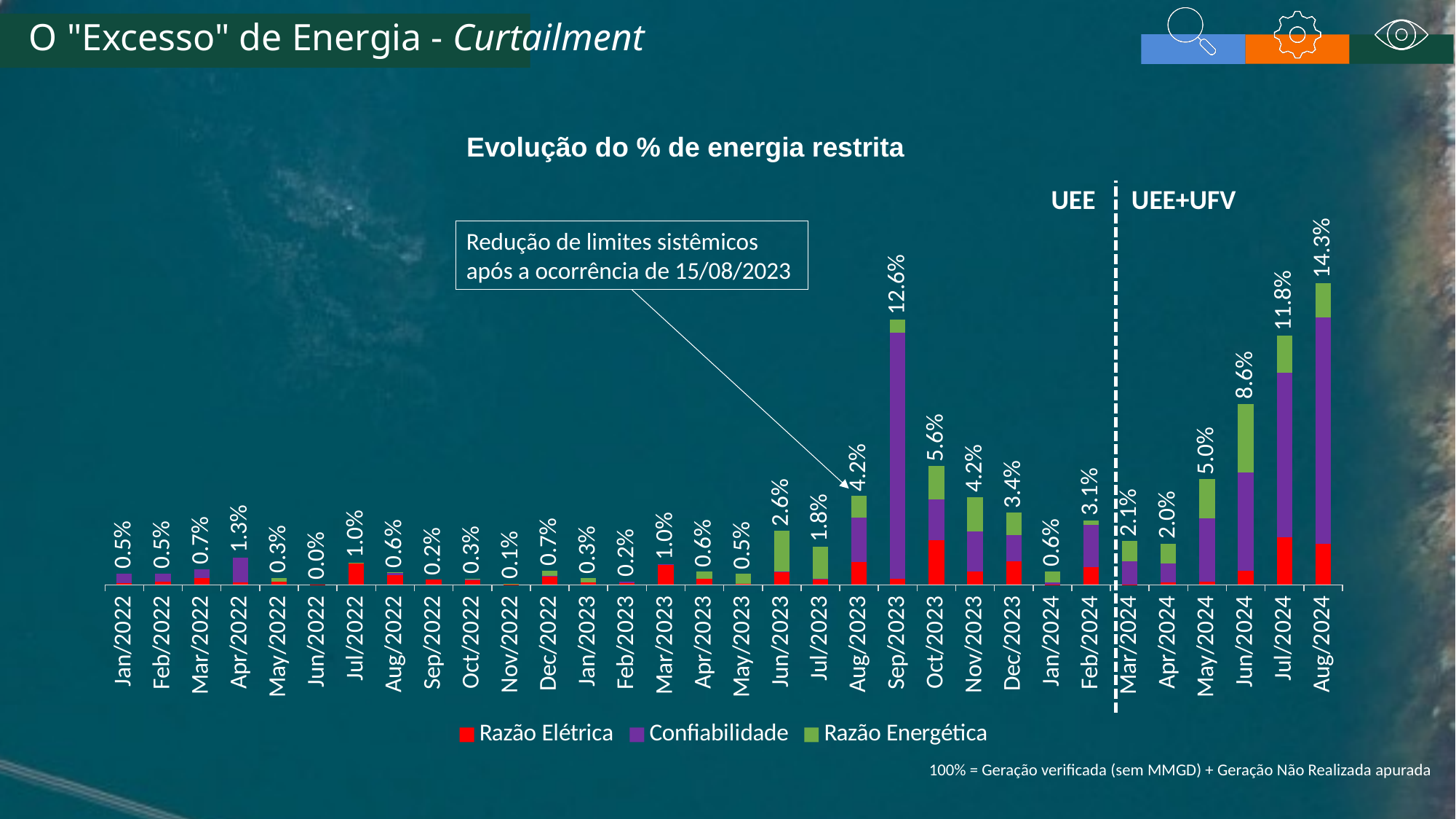
What kind of chart is shown? Stacked bar chart What is the difference between the totals for Aug/2024 and Sep/2023? 1.7 percentage points Do the totals rise or fall from Apr/2024 to Aug/2024? Rise How many series does the legend list? 3 What is the total value labelled for Sep/2023? 12.6% How many months are shown on the x axis? 32 What is the total value labelled for Jun/2023? 2.6% What is the total value labelled for Aug/2024? 14.3% What is the difference between the totals for Jul/2024 and Jun/2024? 3.2 percentage points Which month has the highest total percentage of restricted energy? Aug/2024 Which is larger, the total for Sep/2023 or the total for Jul/2024? Sep/2023 Which month has the lowest total percentage of restricted energy? Jun/2022